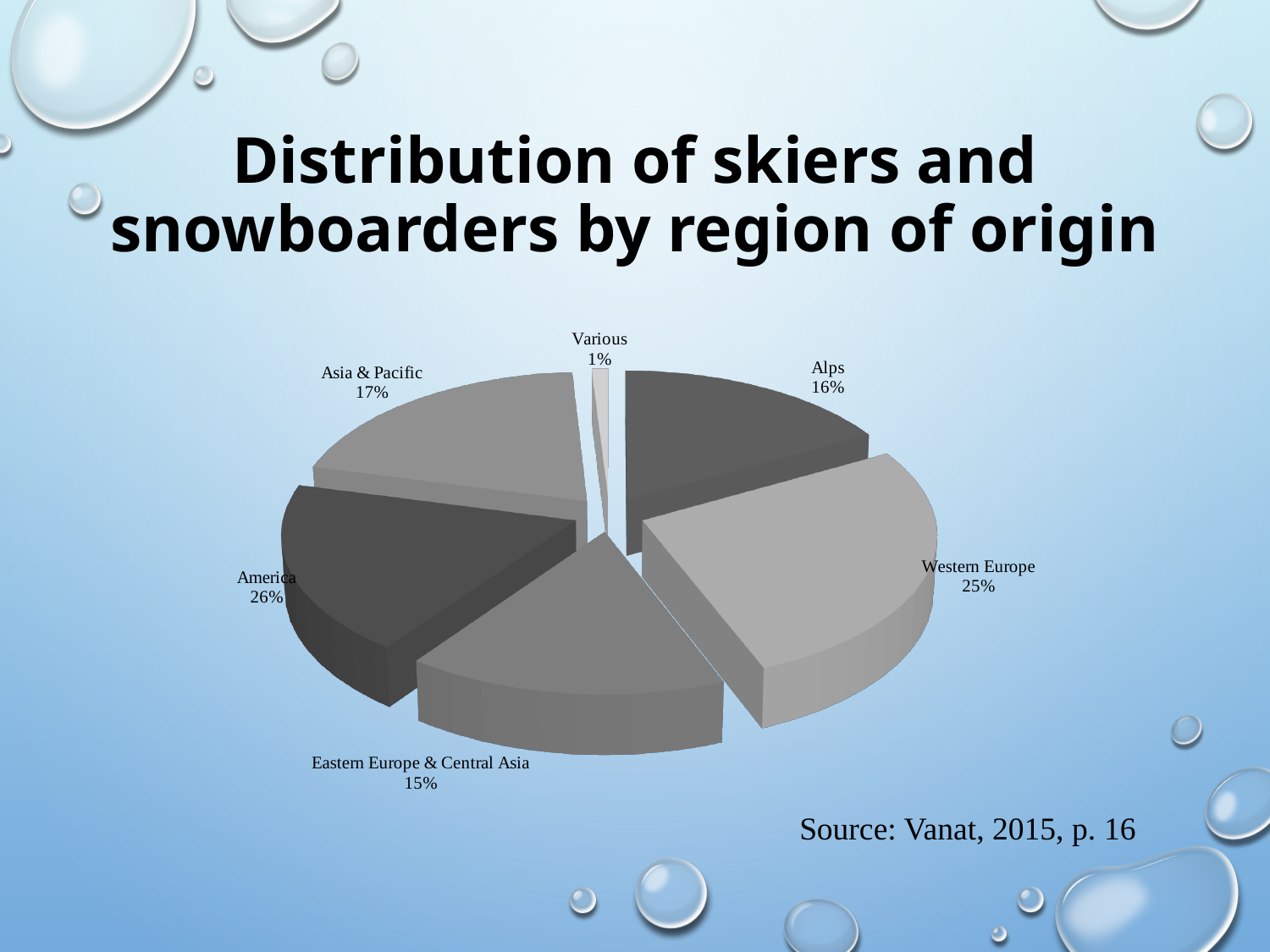
What share of skiers and snowboarders come from Asia & Pacific? 17% What source is cited for the chart? Vanat, 2015, p. 16 What kind of chart is shown on the slide? Pie chart What share of skiers and snowboarders come from Western Europe? 25% What is the difference in percentage points between the Asia & Pacific share and the Eastern Europe & Central Asia share? 2 Which has a larger share, Asia & Pacific or the Alps? Asia & Pacific What share of skiers and snowboarders come from Eastern Europe & Central Asia? 15% Which region has the smallest share of skiers and snowboarders? Various How many regions are shown in the pie chart? 6 What share of skiers and snowboarders come from the Alps? 16% Which region has the largest share of skiers and snowboarders? America What is the difference in percentage points between the America share and the Western Europe share? 1